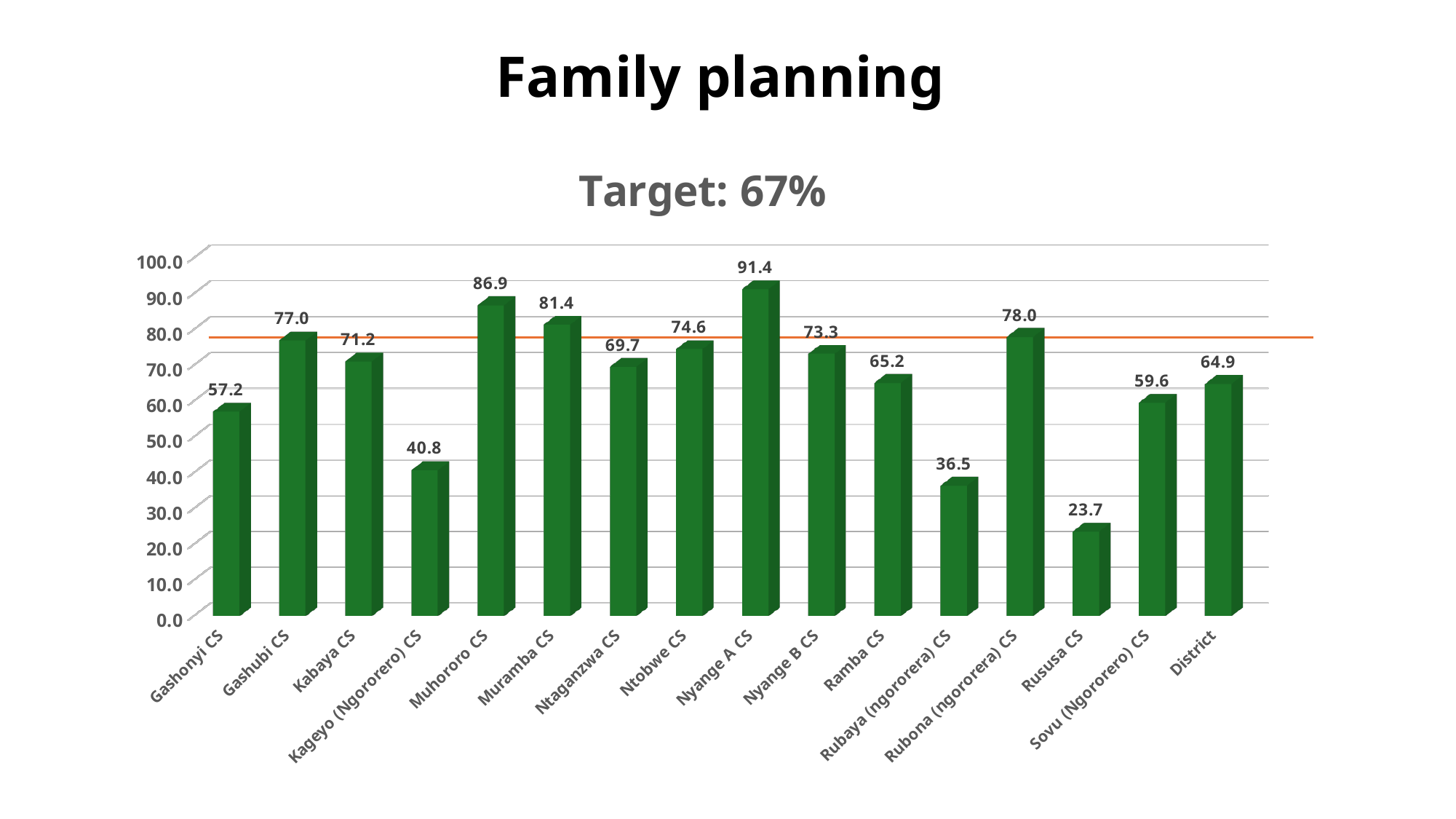
What is the value for Rususa CS? 23.7 What target is stated on the slide? 67% Which category has the lowest value? Rususa CS What is the difference between the values for Muhororo CS and Muramba CS? 5.5 What is the value for Nyange A CS? 91.4 How many categories are shown on the x axis? 16 What is the title of the chart? Target: 67% Which is larger, the value for Gashubi CS or the value for Rubona (ngororera) CS? Rubona (ngororera) CS What is the value for Kageyo (Ngororero) CS? 40.8 What kind of chart is shown on the slide? Bar chart What is the value for District? 64.9 Which category has the highest value? Nyange A CS